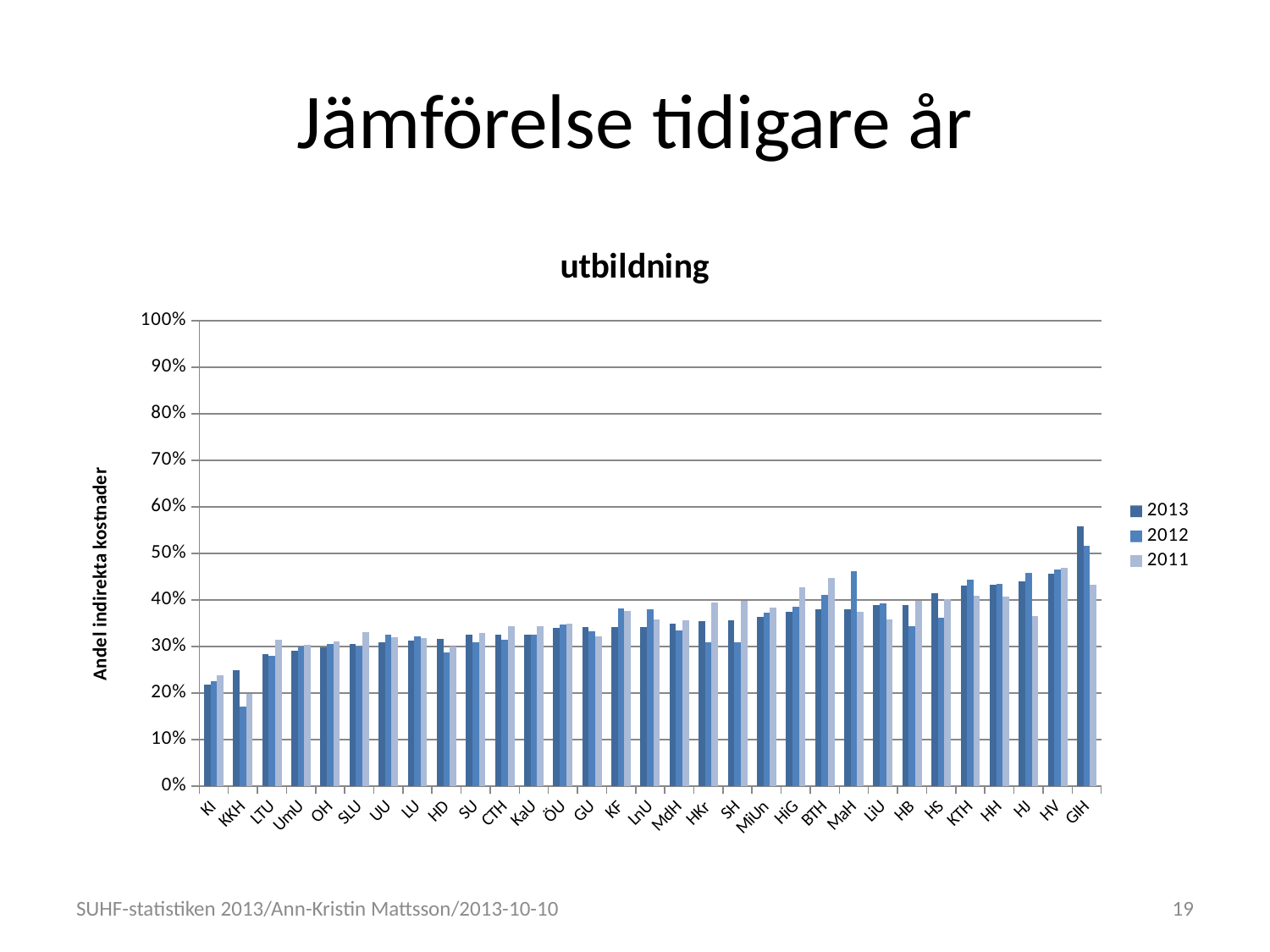
For KKH, which is larger: the 2013 value or the 2012 value? 2013 How many categories are shown on the x axis? 31 Is the 2012 value for KKH greater or less than 20%? less Which category has the lowest value for 2013? KI Is the 2013 value for GIH greater or less than 50%? greater What kind of chart is shown on the slide? bar chart Which category has the lowest value for 2012? KKH How many series does the legend list? 3 Which category has the highest value for 2013? GIH Is the 2012 value for MaH greater or less than 40%? greater Do the 2013 values generally rise or fall from left to right along the x axis? rise